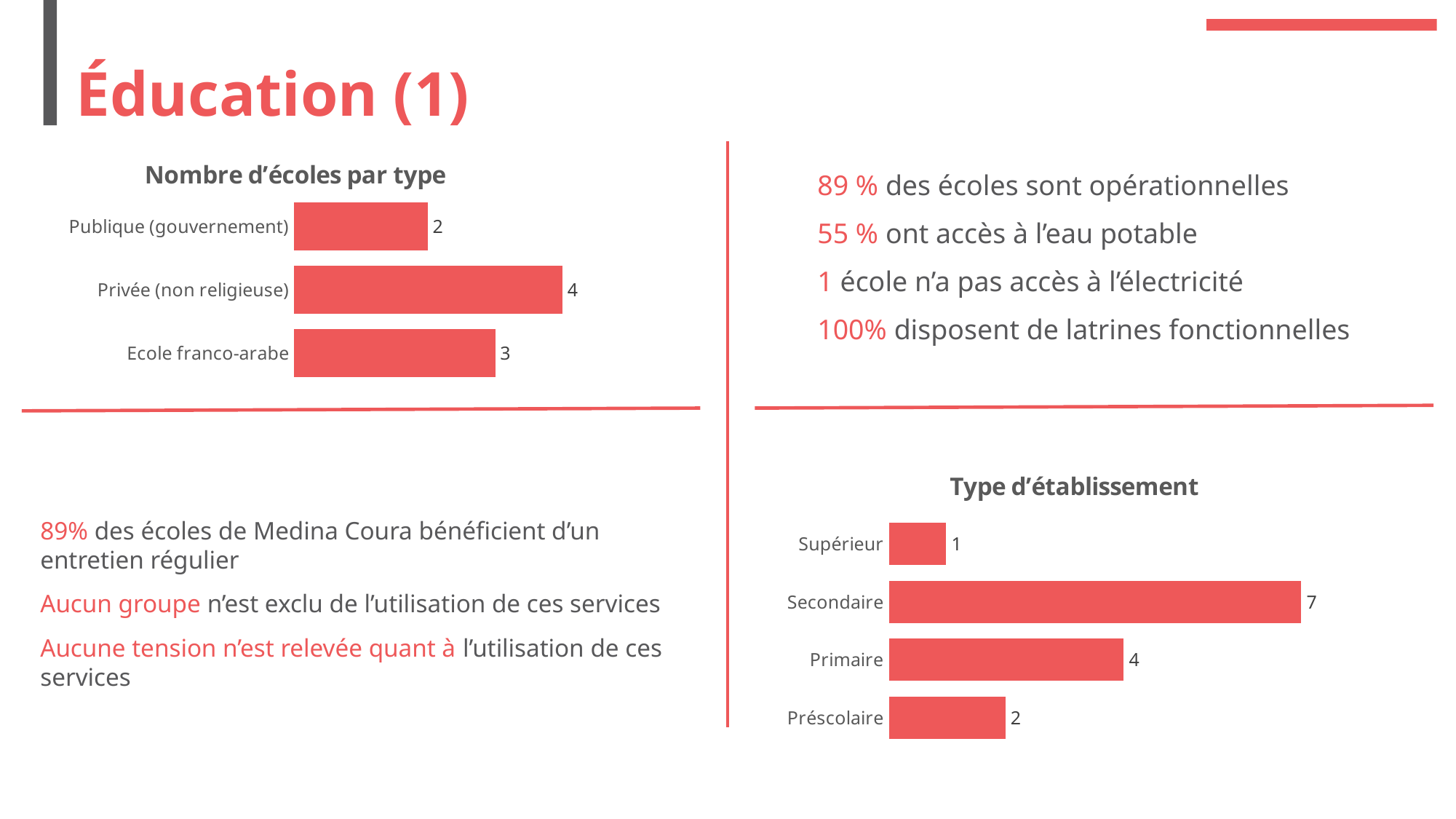
In the 'Type d'établissement' chart, which category has the lowest value? Supérieur In the 'Type d'établissement' chart, what is the value for Secondaire? 7 In the 'Nombre d'écoles par type' chart, what is the value for Privée (non religieuse)? 4 In the 'Type d'établissement' chart, what is the value for Préscolaire? 2 In the 'Nombre d'écoles par type' chart, how many categories are shown? 3 In the 'Nombre d'écoles par type' chart, what kind of chart is it? Bar chart In the 'Nombre d'écoles par type' chart, what is the difference between Privée (non religieuse) and Ecole franco-arabe? 1 In the 'Type d'établissement' chart, which category has the highest value? Secondaire In the 'Type d'établissement' chart, which is larger, Primaire or Préscolaire? Primaire In the 'Type d'établissement' chart, what is the difference between Secondaire and Primaire? 3 In the 'Type d'établissement' chart, how many categories are shown? 4 In the 'Nombre d'écoles par type' chart, which category has the lowest value? Publique (gouvernement)